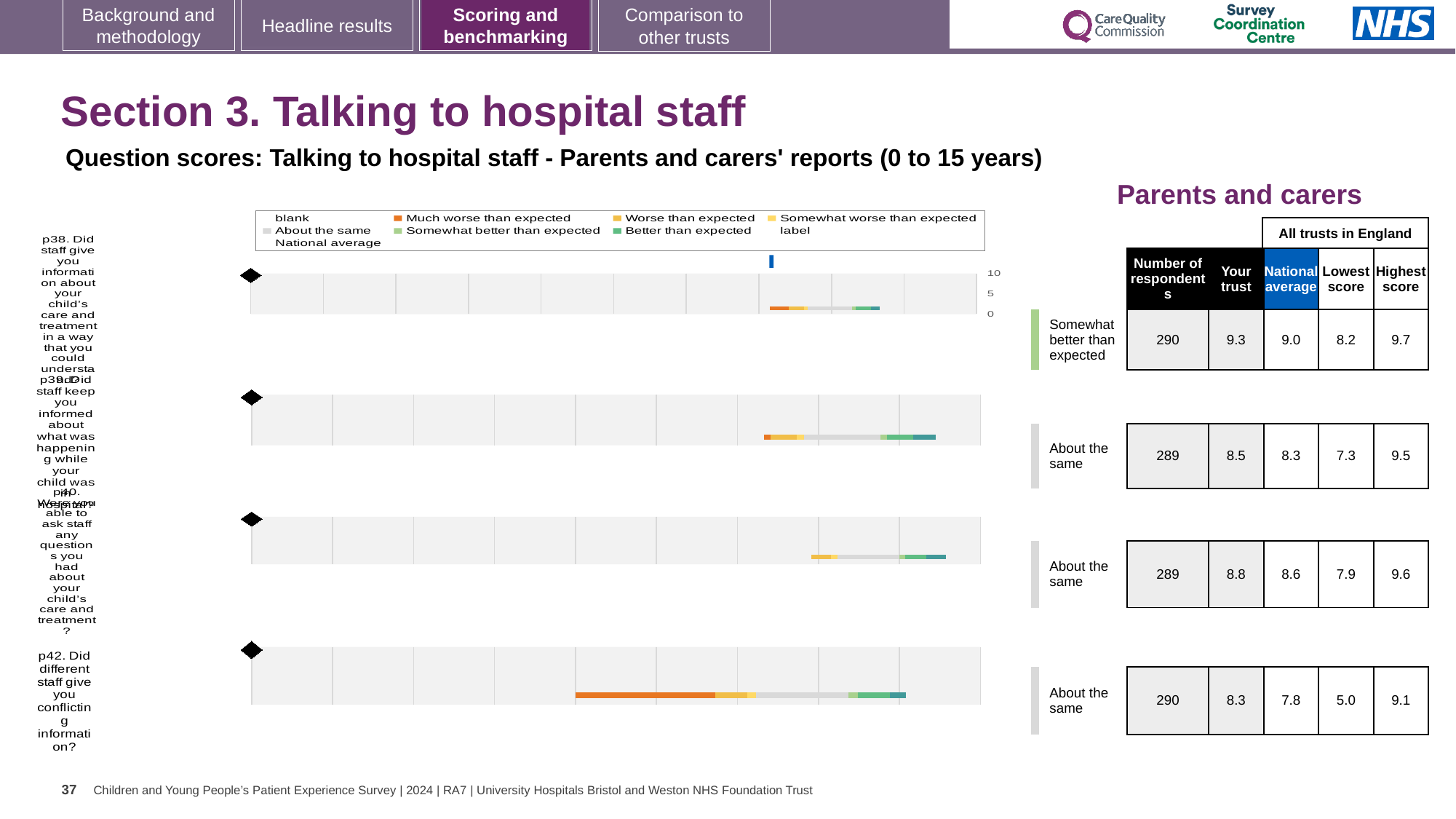
What benchmark category is shown for p38 next to the chart? Somewhat better than expected In the table beside the chart, what is the national average for p38 (Did staff give you information about your child's care and treatment in a way that you could understand?)? 9.0 What is the lowest score among all trusts in England for p42? 5.0 For p40, which is larger: the 'Your trust' score or the national average? Your trust How many survey questions (bars) are plotted in the chart? 4 In the table beside the chart, what is the 'Your trust' score for p42 (Did different staff give you conflicting information?)? 8.3 Which question has the highest 'Your trust' score in the table beside the chart? p38 How many respondents answered p39 (Did staff keep you informed about what was happening while your child was in hospital?)? 289 How many entries does the chart legend list? 9 For p38, how much higher is the 'Your trust' score than the national average? 0.3 Which question has the lowest 'Your trust' score in the table beside the chart? p42 What kind of chart is used to show the question scores for Talking to hospital staff? bar chart